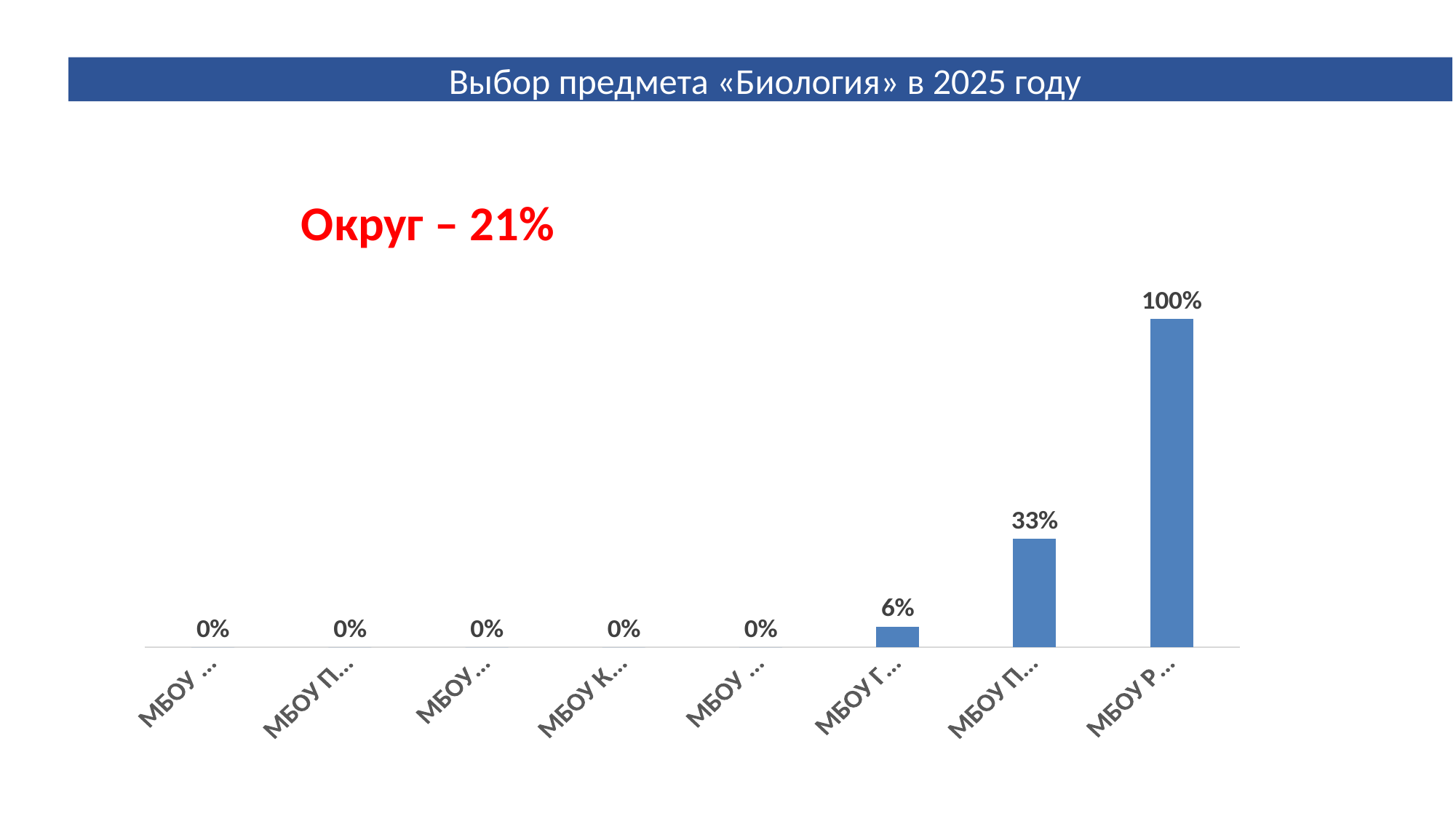
Which bar has the highest value in the chart? the rightmost bar (МБОУ Р...) What is the value shown for the fourth bar from the left in the chart? 0% What is the difference between the seventh bar (33%) and the sixth bar (6%)? 27% What is the value shown for the rightmost bar in the chart? 100% Which is larger: the value of the sixth bar from the left or the seventh bar from the left? the seventh bar What is the difference between the rightmost bar (100%) and the seventh bar (33%)? 67% How many bars in the chart have a value of 0%? 5 What is the value shown for the seventh bar from the left in the chart? 33% What is the title of the slide containing the chart? Выбор предмета «Биология» в 2025 году What is the value shown for the sixth bar from the left in the chart? 6% How many categories (bars) are plotted along the x axis of the chart? 8 What kind of chart is shown on the slide? bar chart